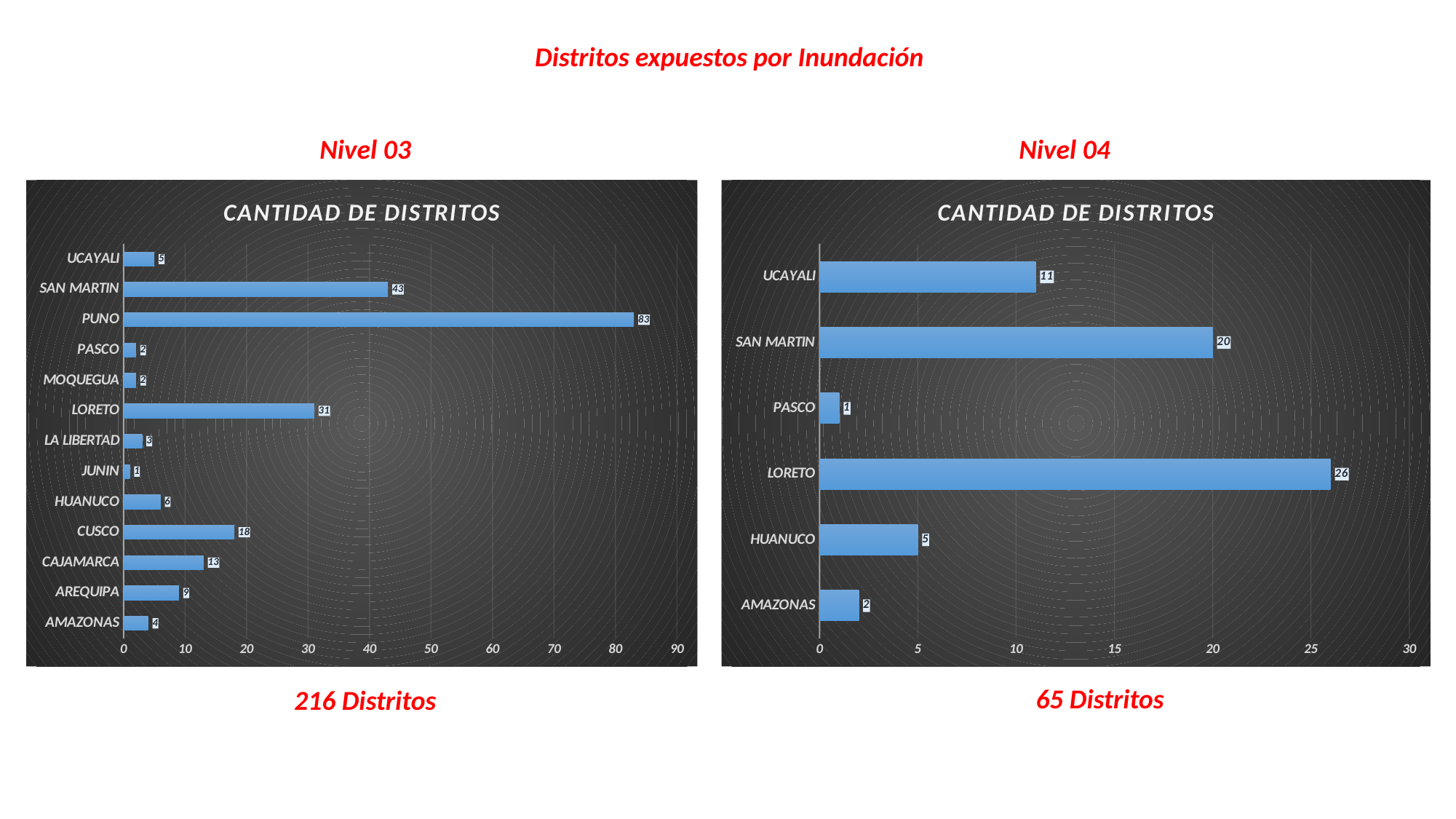
In the Nivel 04 chart, what is the value for SAN MARTIN? 20 In the Nivel 03 chart, which is larger, the value for CAJAMARCA or the value for AREQUIPA? CAJAMARCA How many categories are shown in the Nivel 03 chart? 13 In the Nivel 04 chart, what is the difference between the values for LORETO and UCAYALI? 15 In the Nivel 03 chart, which category has the lowest value? JUNIN In the Nivel 03 chart, what is the difference between the values for SAN MARTIN and CUSCO? 25 How many categories are shown in the Nivel 04 chart? 6 In the Nivel 04 chart, which category has the highest value? LORETO In the Nivel 03 chart, what is the value for PUNO? 83 What type of chart is the Nivel 04 chart? Bar chart In the Nivel 04 chart, which category has the lowest value? PASCO In the Nivel 03 chart, what is the value for LORETO? 31